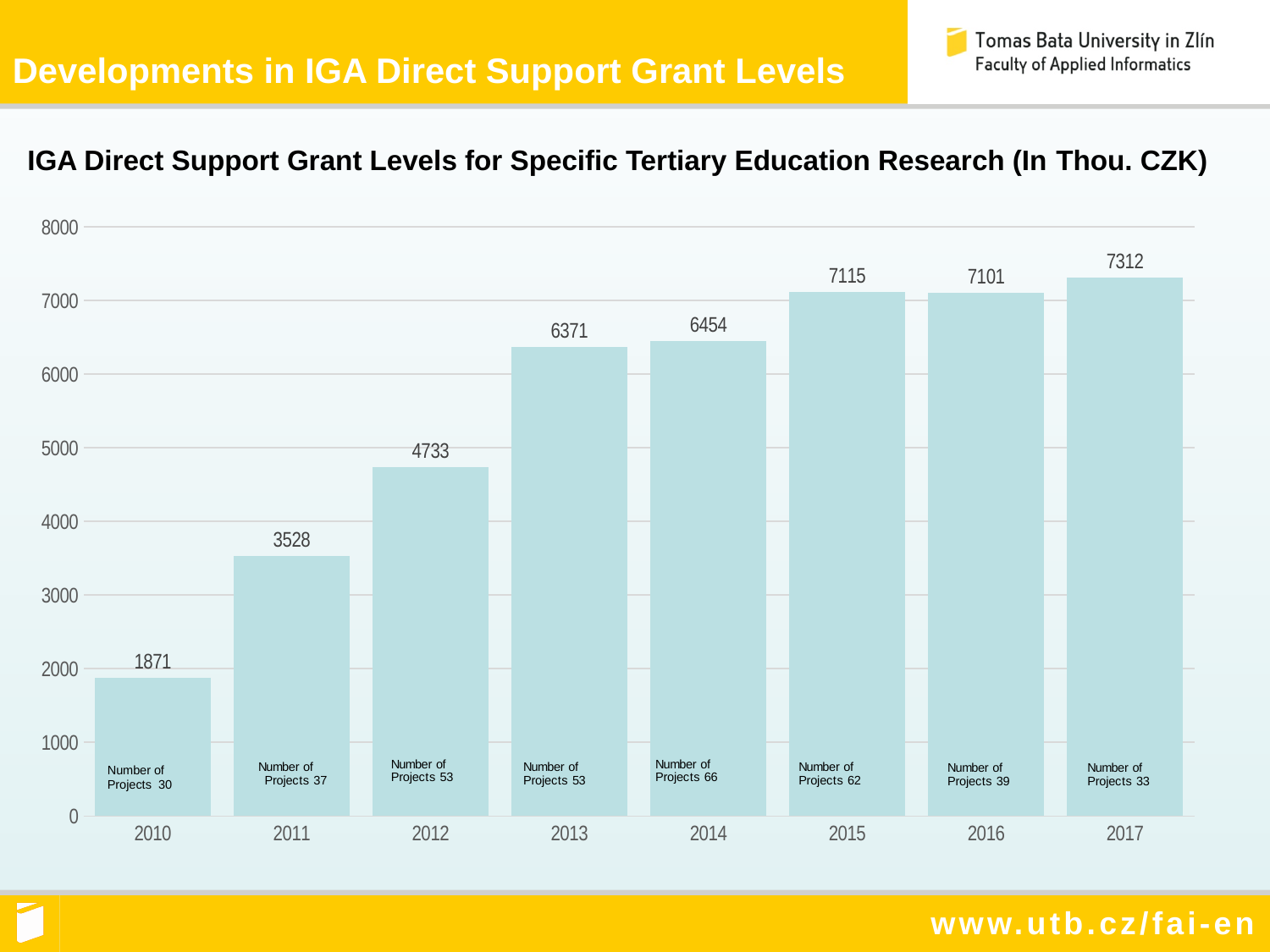
Which year has the lowest grant level? 2010 Is the grant level for 2015 greater or less than 7000? greater How many years are shown on the x axis? 8 Do the grant levels generally rise or fall from 2010 to 2017? rise How many projects are listed for 2014? 66 What is the grant level shown for 2010? 1871 Which year has the highest grant level? 2017 What is the IGA direct support grant level for 2013? 6371 What is the difference between the grant levels for 2012 and 2011? 1205 What kind of chart is shown on the slide? bar chart Which year has a larger grant level, 2014 or 2013? 2014 In what unit are the grant levels expressed according to the chart title? Thou. CZK